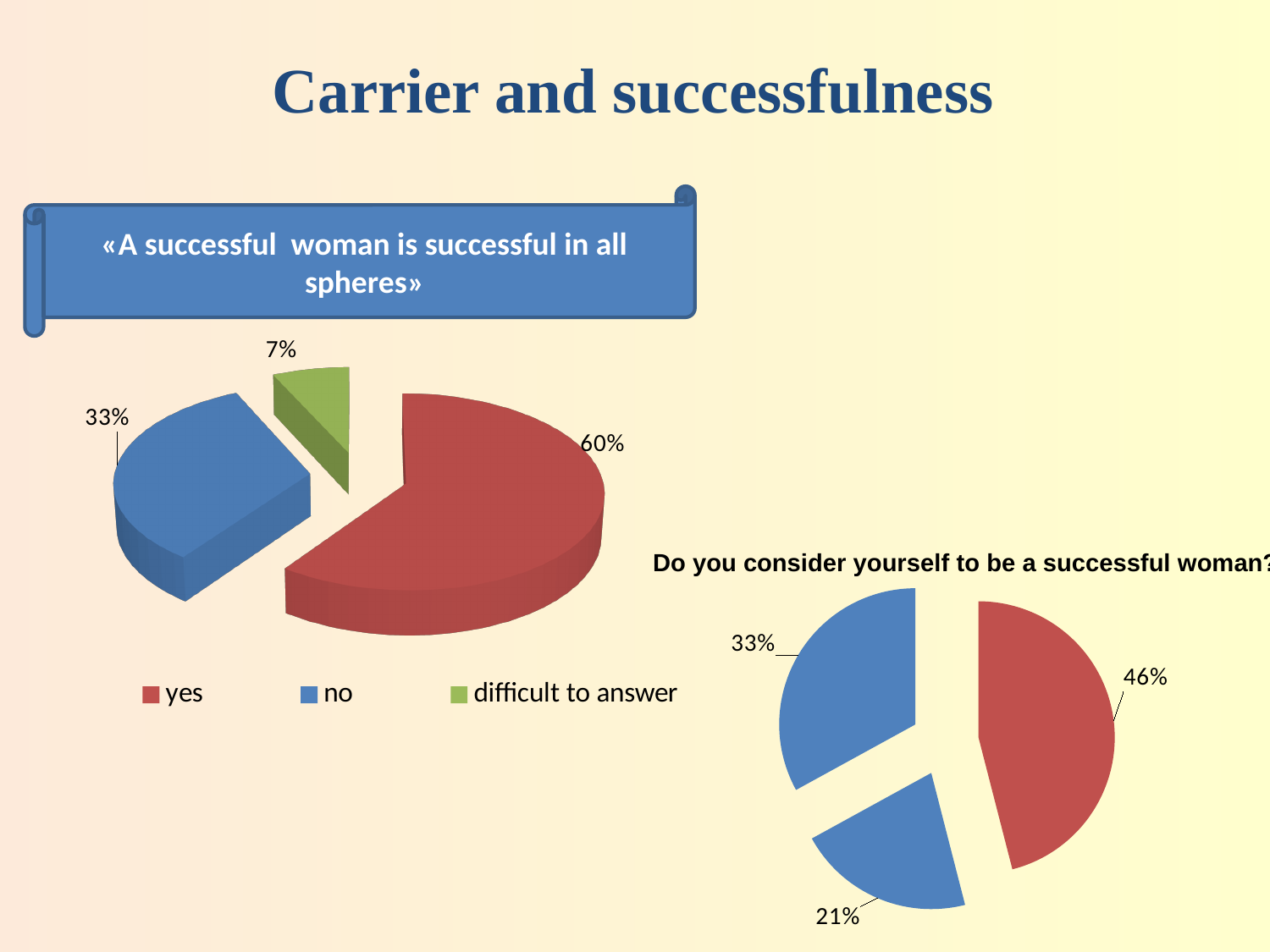
In the left pie chart titled «A successful woman is successful in all spheres», what is the difference in percentage points between "yes" and "no"? 27 In the pie chart "Do you consider yourself to be a successful woman?", what is the largest percentage shown? 46% In the left pie chart titled «A successful woman is successful in all spheres», what percentage answered "no"? 33% In the left pie chart titled «A successful woman is successful in all spheres», which response has the smallest share? difficult to answer In the left pie chart titled «A successful woman is successful in all spheres», how many entries does the legend list? 3 In the left pie chart titled «A successful woman is successful in all spheres», which response has the largest share? yes In the pie chart "Do you consider yourself to be a successful woman?", how many slices are there? 3 In the left pie chart titled «A successful woman is successful in all spheres», what percentage found it "difficult to answer"? 7% In the left pie chart titled «A successful woman is successful in all spheres», what colour is the "no" slice? blue What kind of chart is used for "Do you consider yourself to be a successful woman?"? pie chart In the pie chart "Do you consider yourself to be a successful woman?", what is the smallest percentage shown? 21% In the left pie chart titled «A successful woman is successful in all spheres», what percentage answered "yes"? 60%